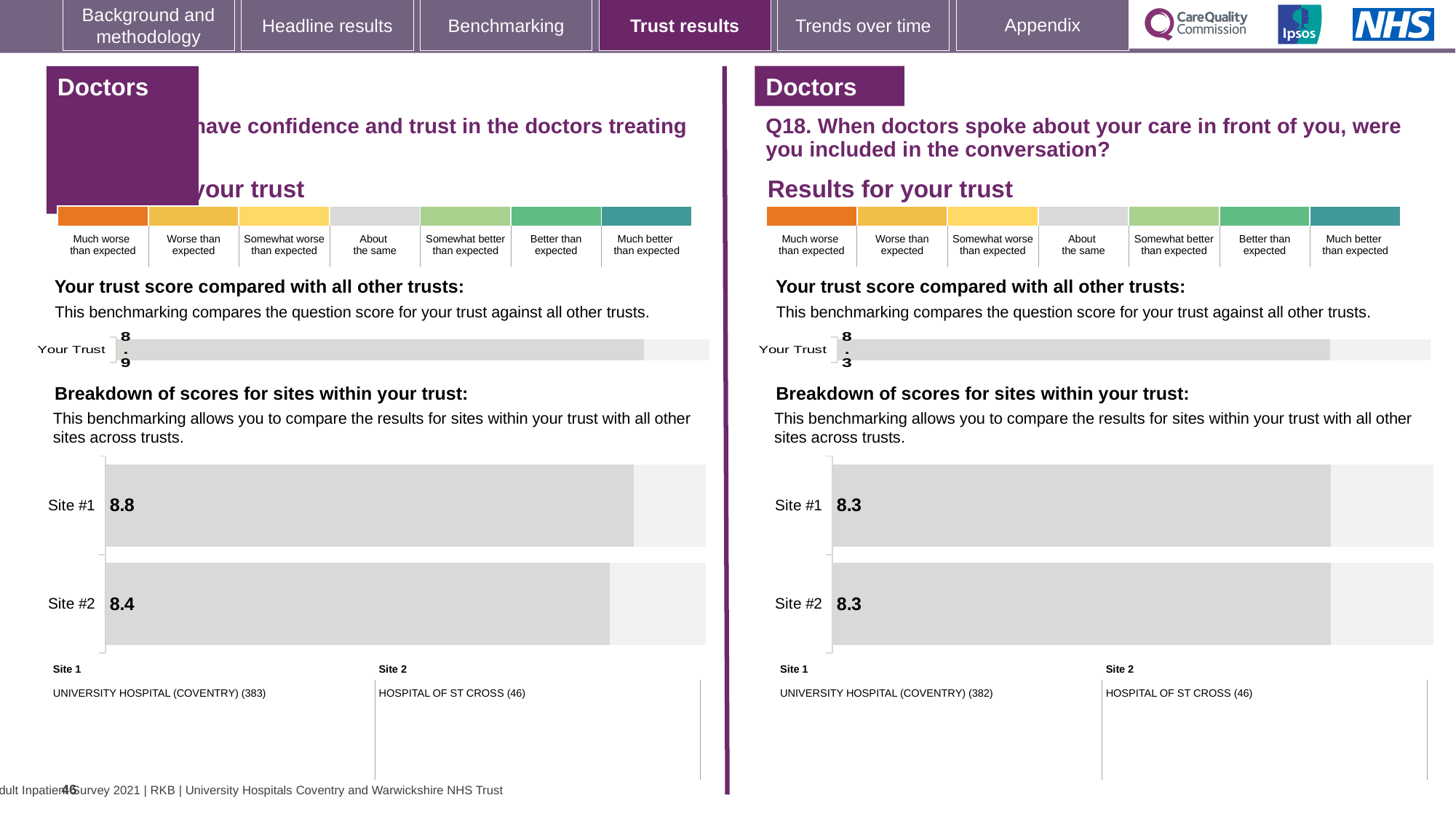
On the Q18 'Your trust score compared with all other trusts' chart on the right, what is the value for Your Trust? 8.3 On the left-hand 'Your trust score compared with all other trusts' chart, what is the value for Your Trust? 8.9 On the left-hand site breakdown chart, what is the score for Site #1? 8.8 What type of chart is the Q18 site breakdown chart on the right? Bar chart How many sites are shown on the left-hand site breakdown chart? 2 On the Q18 site breakdown chart on the right, what is the score for Site #2? 8.3 On the Q18 site breakdown chart on the right, what is the difference between the Site #1 and Site #2 scores? 0 On the left-hand site breakdown chart, is the score for Site #1 greater or less than the score for Site #2? greater On the left-hand site breakdown chart, what is the difference between the Site #1 and Site #2 scores? 0.4 On the left-hand site breakdown chart, what is the score for Site #2? 8.4 On the left-hand site breakdown chart, which site has the higher score? Site #1 On the Q18 site breakdown chart on the right, what is the score for Site #1? 8.3